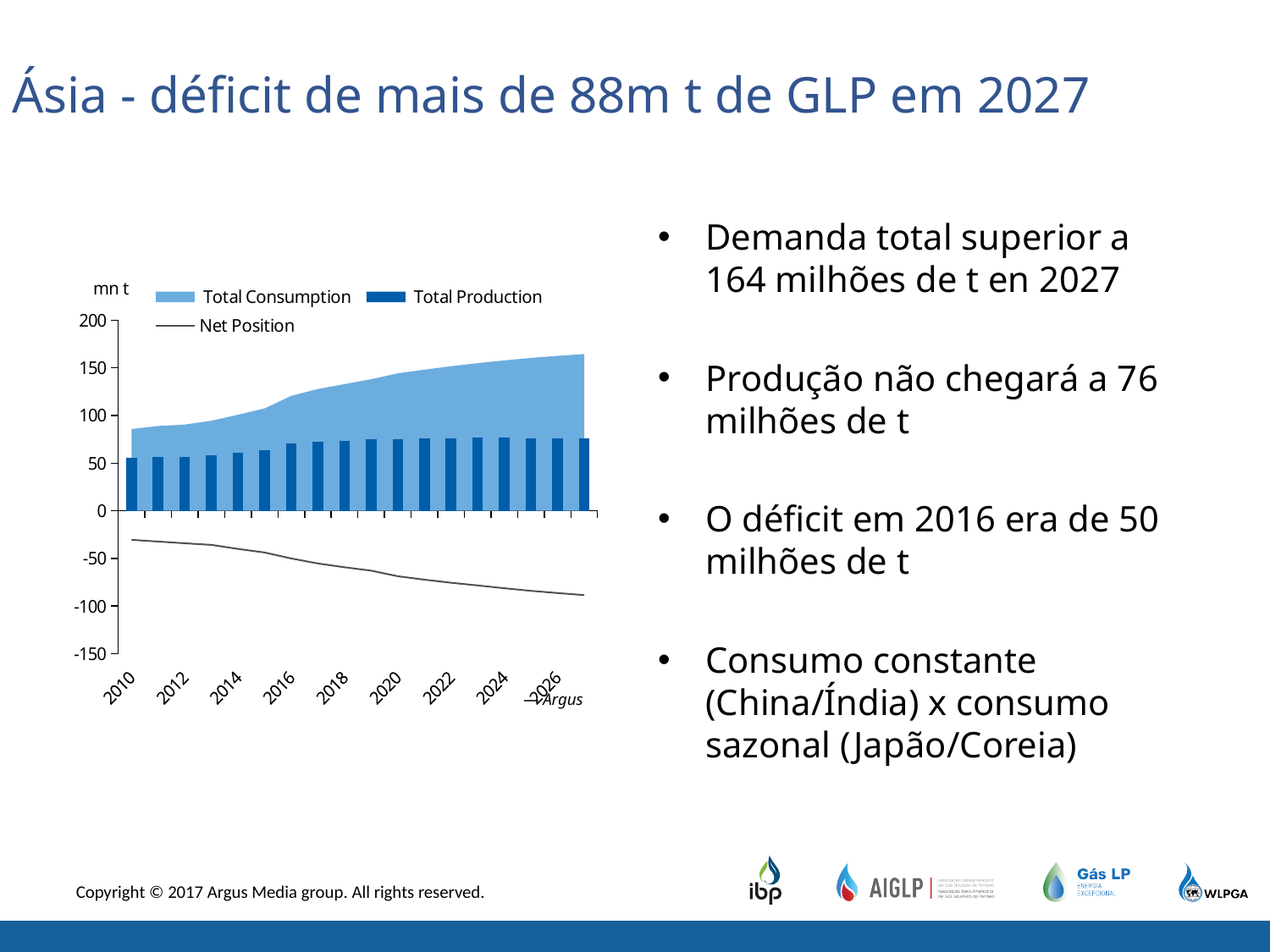
What kind of chart is shown on the slide? A combination chart with an area, bars and a line Does Total Consumption rise or fall from 2010 to 2026? rise Is the Total Consumption value for 2010 greater or less than 100? less In 2020, which is larger: Total Consumption or Total Production? Total Consumption How many series does the chart legend list? 3 Does the Net Position line rise or fall from 2010 to 2026? fall Is the Total Consumption value for 2026 greater or less than 150? greater Is the Net Position value for 2010 greater or less than -50? greater What unit is shown on the chart's vertical axis? mn t Which series is drawn as bars in the chart? Total Production